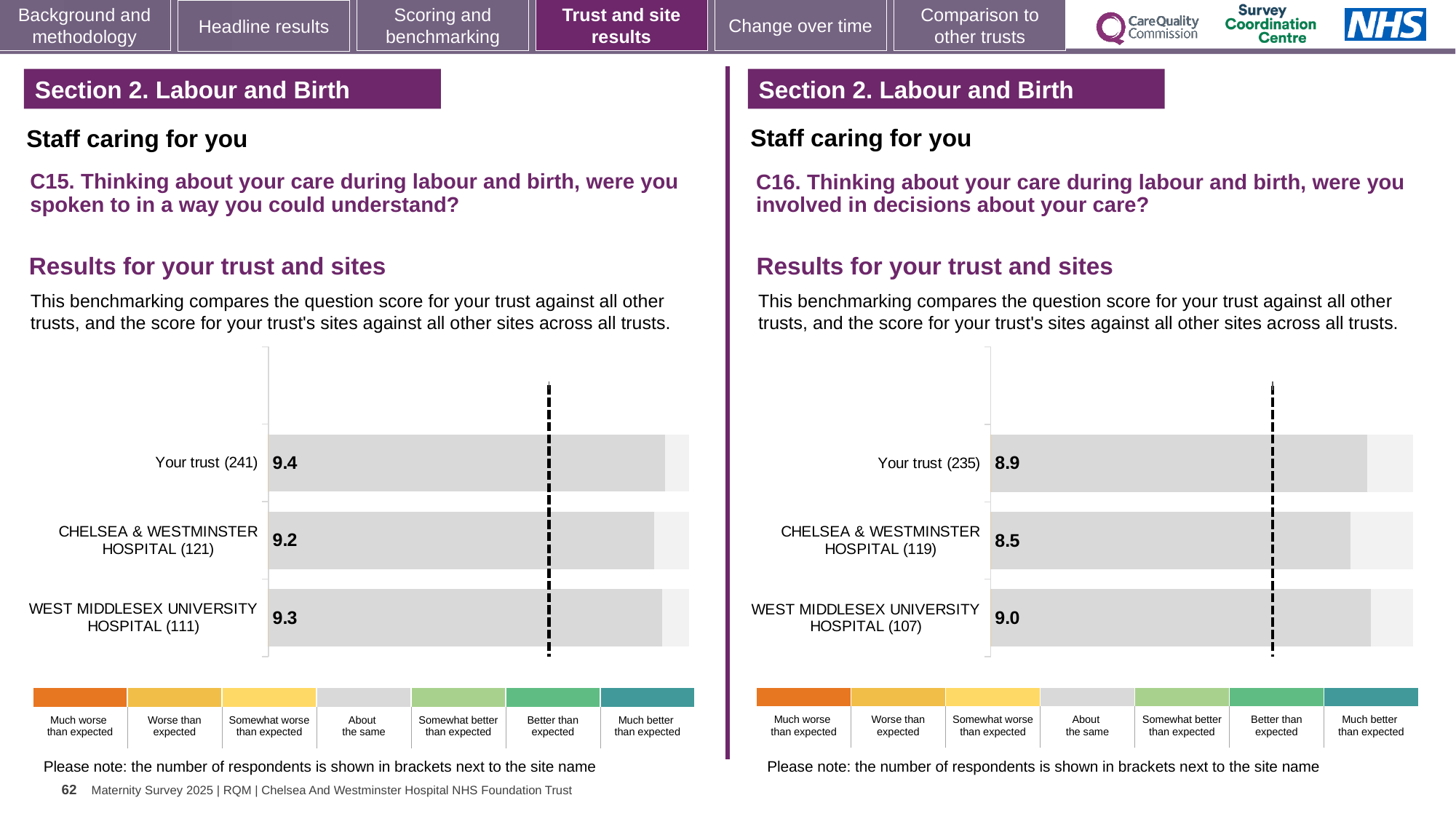
How many rows (bars) are shown in the C15 chart on the left? 3 In the C16 chart on the right, what is the difference between the scores for WEST MIDDLESEX UNIVERSITY HOSPITAL (107) and CHELSEA & WESTMINSTER HOSPITAL (119)? 0.5 In the C15 chart on the left, which row has the highest score? Your trust (241) In the C15 chart on the left, what is the score for WEST MIDDLESEX UNIVERSITY HOSPITAL (111)? 9.3 What kind of chart is used on the right for question C16? Bar chart In the C16 chart on the right, what is the score for Your trust (235)? 8.9 In the C16 chart on the right, what is the score for WEST MIDDLESEX UNIVERSITY HOSPITAL (107)? 9.0 In the C15 chart on the left, what is the score for CHELSEA & WESTMINSTER HOSPITAL (121)? 9.2 In the C15 chart on the left, what is the score for Your trust (241)? 9.4 In the C16 chart on the right, which row has the lowest score? CHELSEA & WESTMINSTER HOSPITAL (119) In the C16 chart on the right, what is the score for CHELSEA & WESTMINSTER HOSPITAL (119)? 8.5 In the C15 chart on the left, which has the larger score: CHELSEA & WESTMINSTER HOSPITAL (121) or WEST MIDDLESEX UNIVERSITY HOSPITAL (111)? WEST MIDDLESEX UNIVERSITY HOSPITAL (111)